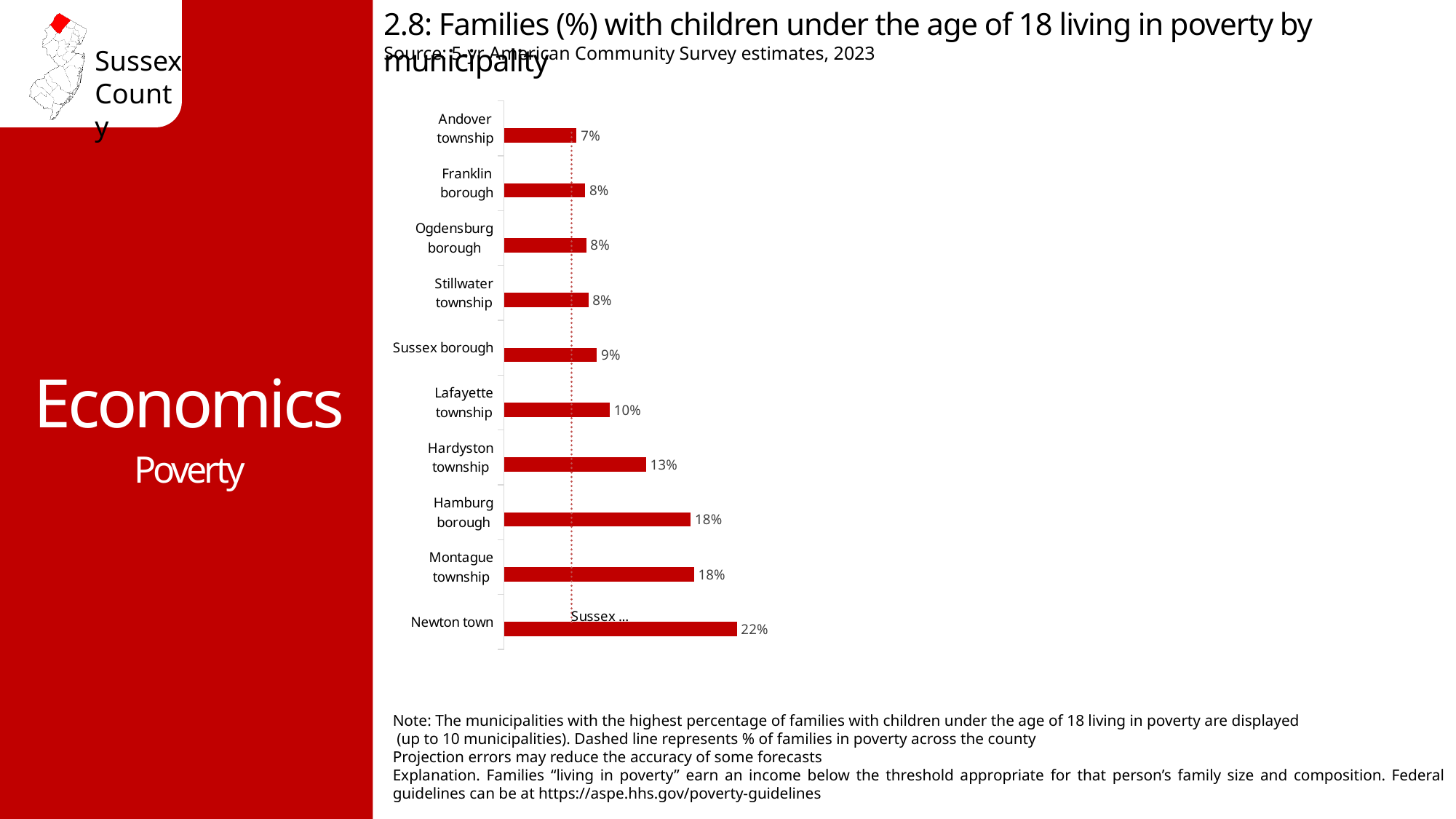
Which municipality has the lowest percentage shown on the chart? Andover township What is the difference between the values for Hardyston township and Sussex borough? 4% What does the dashed vertical line on the chart represent? % of families in poverty across the county What is the value shown for Hardyston township? 13% What is the value shown for Andover township? 7% How many municipalities are shown on the chart? 10 Which has a higher value, Lafayette township or Franklin borough? Lafayette township What kind of chart is used on this slide? Bar chart Which municipality has the highest percentage of families with children under 18 living in poverty? Newton town What is the value shown for Lafayette township? 10% What is the difference between the values for Newton town and Hamburg borough? 4% What percentage of families with children under 18 are living in poverty in Newton town? 22%